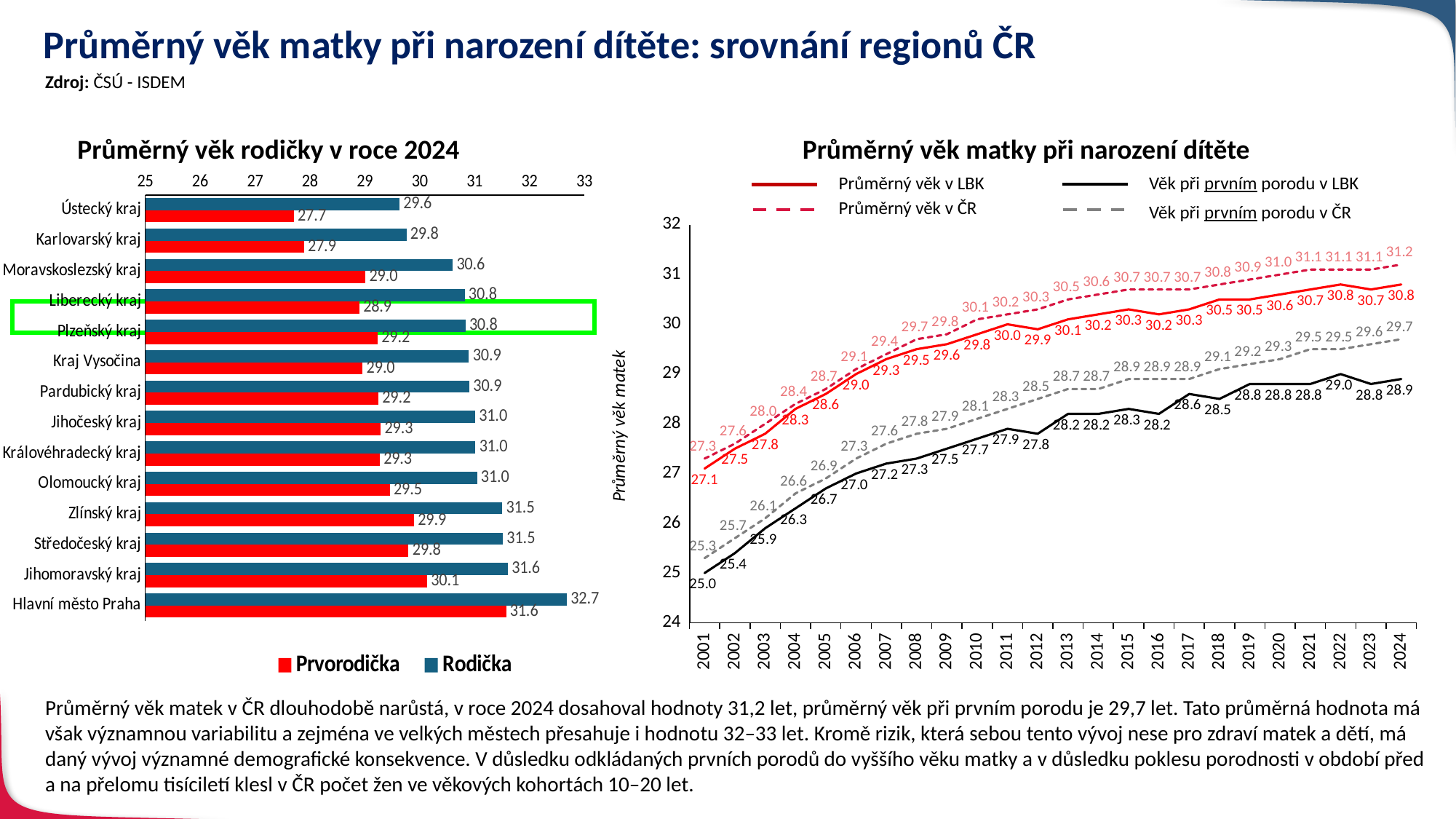
In the chart 'Průměrný věk matky při narození dítěte', does the 'Průměrný věk v LBK' series rise or fall from 2001 to 2024? Rise In the chart 'Průměrný věk matky při narození dítěte', what is the value of 'Věk při prvním porodu v LBK' in 2001? 25.0 In the chart 'Průměrný věk matky při narození dítěte', what is the value of 'Průměrný věk v ČR' in 2024? 31.2 In the chart 'Průměrný věk rodičky v roce 2024', what is the Prvorodička value for Liberecký kraj? 28.9 In the chart 'Průměrný věk rodičky v roce 2024', how many regions are shown? 14 In the chart 'Průměrný věk rodičky v roce 2024', which region has the highest Rodička value? Hlavní město Praha In the chart 'Průměrný věk matky při narození dítěte', how many series does the legend list? 4 What kind of chart is 'Průměrný věk rodičky v roce 2024'? Bar chart In the chart 'Průměrný věk rodičky v roce 2024', what is the difference between the Rodička and Prvorodička values for Jihomoravský kraj? 1.5 In the chart 'Průměrný věk rodičky v roce 2024', how many series does the legend list? 2 In the chart 'Průměrný věk rodičky v roce 2024', what is the Rodička value for Hlavní město Praha? 32.7 In the chart 'Průměrný věk rodičky v roce 2024', which region has the lowest Prvorodička value? Ústecký kraj